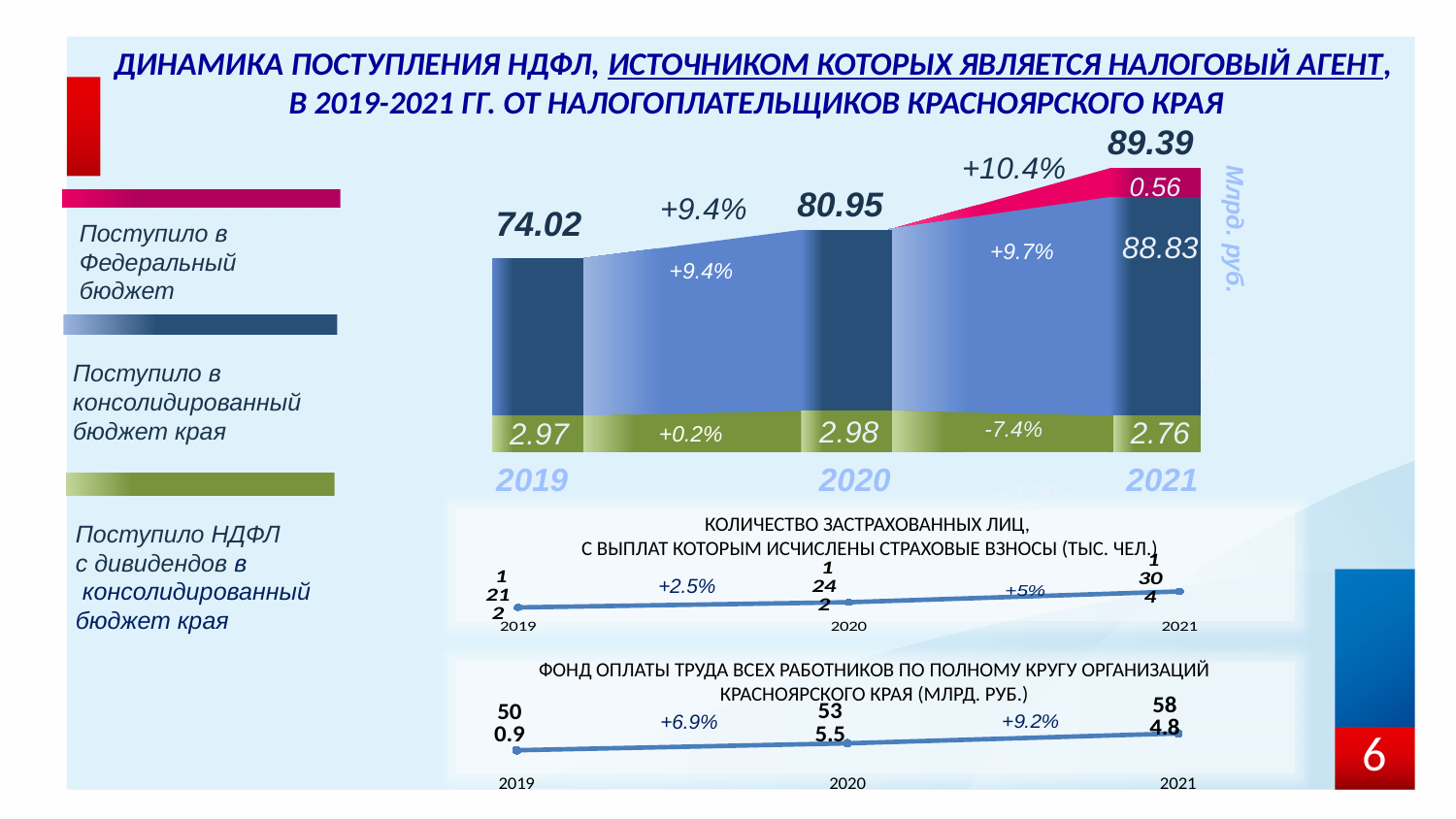
In the top chart, what percentage change is shown for the green (dividend) segment from 2020 to 2021? -7.4% How many years are shown on the x axis of the top chart? 3 In the top chart, which year has the highest total value? 2021 In the top chart, what is the value of the red (federal budget) segment for 2021? 0.56 In the top chart, what is the difference between the total values for 2020 and 2019? 6.93 In the top chart, which year has the lowest green (dividend) value? 2021 In the bottom chart (Фонд оплаты труда), what percentage change is shown from 2020 to 2021? +9.2% In the top chart, what is the value of the green (dividend) segment for 2020? 2.98 In the top chart, what is the total value shown for 2019? 74.02 In the middle chart (Количество застрахованных лиц), do the values rise or fall from 2019 to 2021? rise In the top chart, what is the total value shown for 2021? 89.39 In the top chart, what is the value of the blue (consolidated regional budget) segment for 2021? 88.83